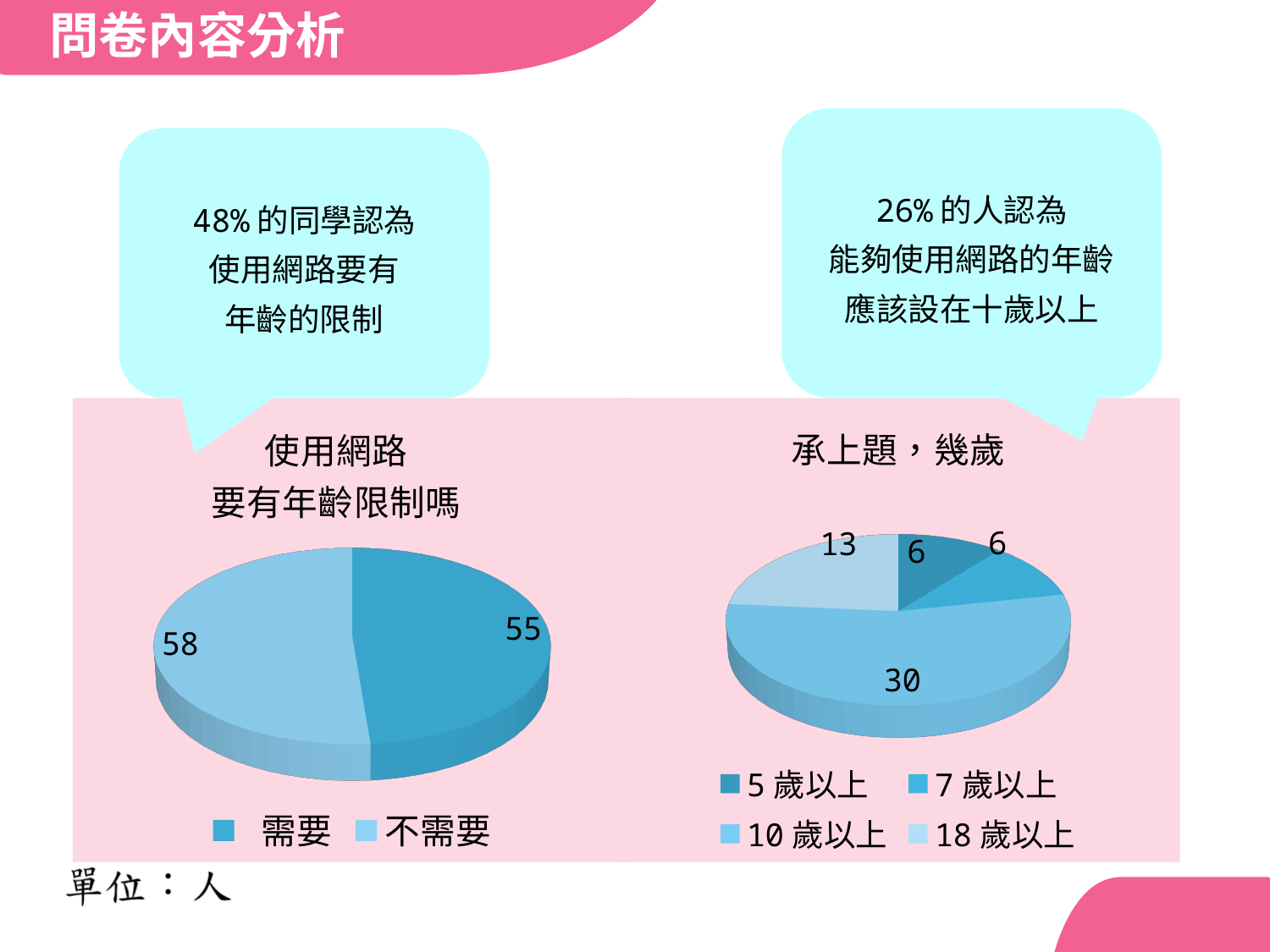
In the chart titled 承上題，幾歲, how many people chose 10 歲以上? 30 In the chart titled 承上題，幾歲, what is the difference between the 10 歲以上 and 18 歲以上 values? 17 In the chart titled 承上題，幾歲, how many categories does the legend list? 4 What kind of chart is the chart titled 承上題，幾歲? Pie chart In the chart titled 承上題，幾歲, how many people chose 18 歲以上? 13 In the chart titled 使用網路要有年齡限制嗎, what is the difference between the 不需要 and 需要 values? 3 In the chart titled 使用網路要有年齡限制嗎, how many people answered 需要? 55 In the chart titled 承上題，幾歲, how many people chose 7 歲以上? 6 In the chart titled 使用網路要有年齡限制嗎, which category has the larger value, 需要 or 不需要? 不需要 In the chart titled 使用網路要有年齡限制嗎, how many categories does the legend list? 2 In the chart titled 使用網路要有年齡限制嗎, how many people answered 不需要? 58 In the chart titled 承上題，幾歲, which category has the highest value? 10 歲以上